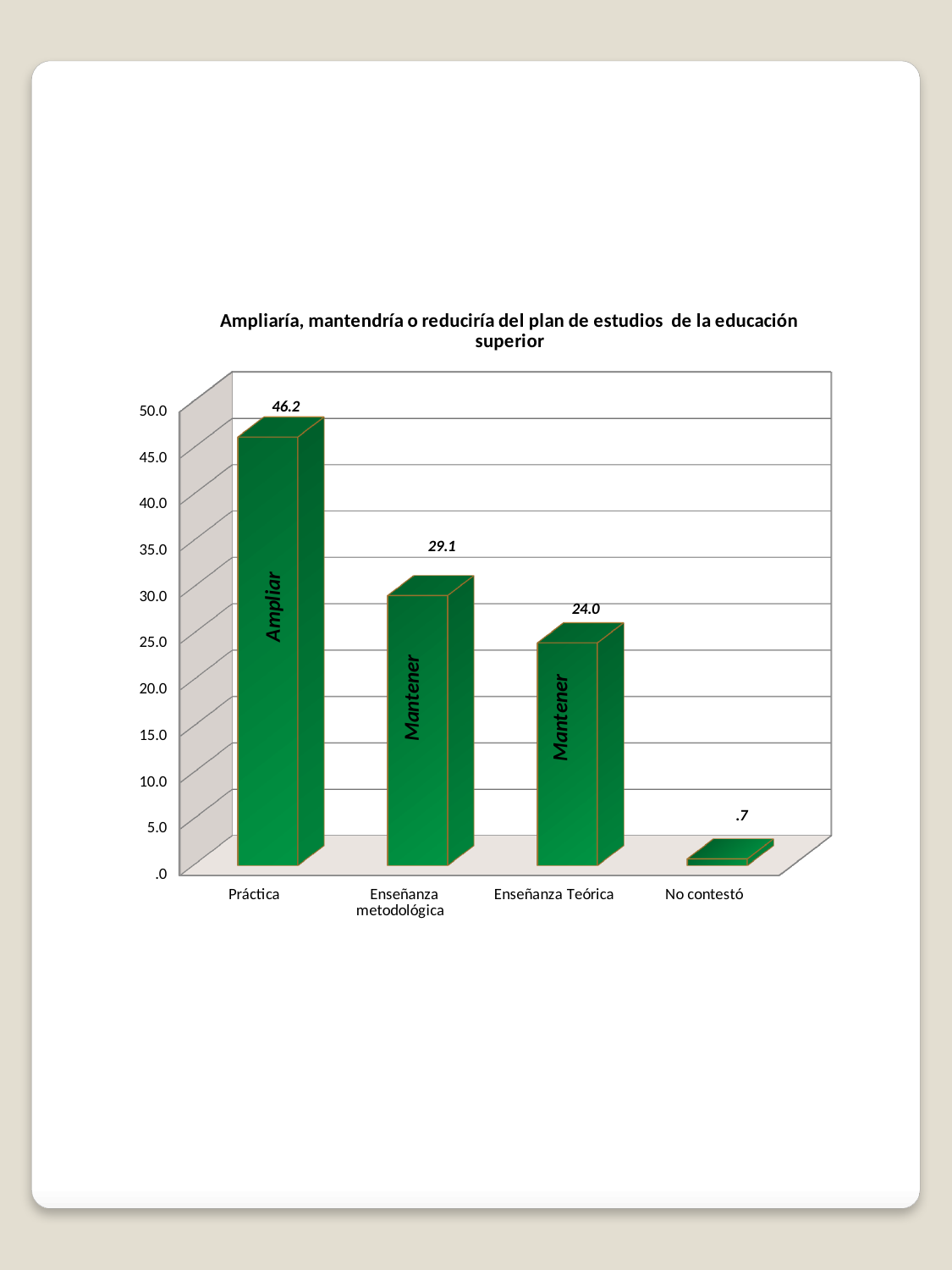
Do the values rise or fall from left to right along the x axis? Fall Which category has the lowest value? No contestó What is the value for Enseñanza Teórica? 24.0 Which is larger, the value for Enseñanza metodológica or Enseñanza Teórica? Enseñanza metodológica What is the difference between the values for Práctica and Enseñanza metodológica? 17.1 What is the value for No contestó? .7 What kind of chart is shown? Bar chart What is the value for Práctica? 46.2 What is the value for Enseñanza metodológica? 29.1 What word is written inside the bar for Práctica? Ampliar Which category has the highest value? Práctica How many categories are shown on the x axis? 4